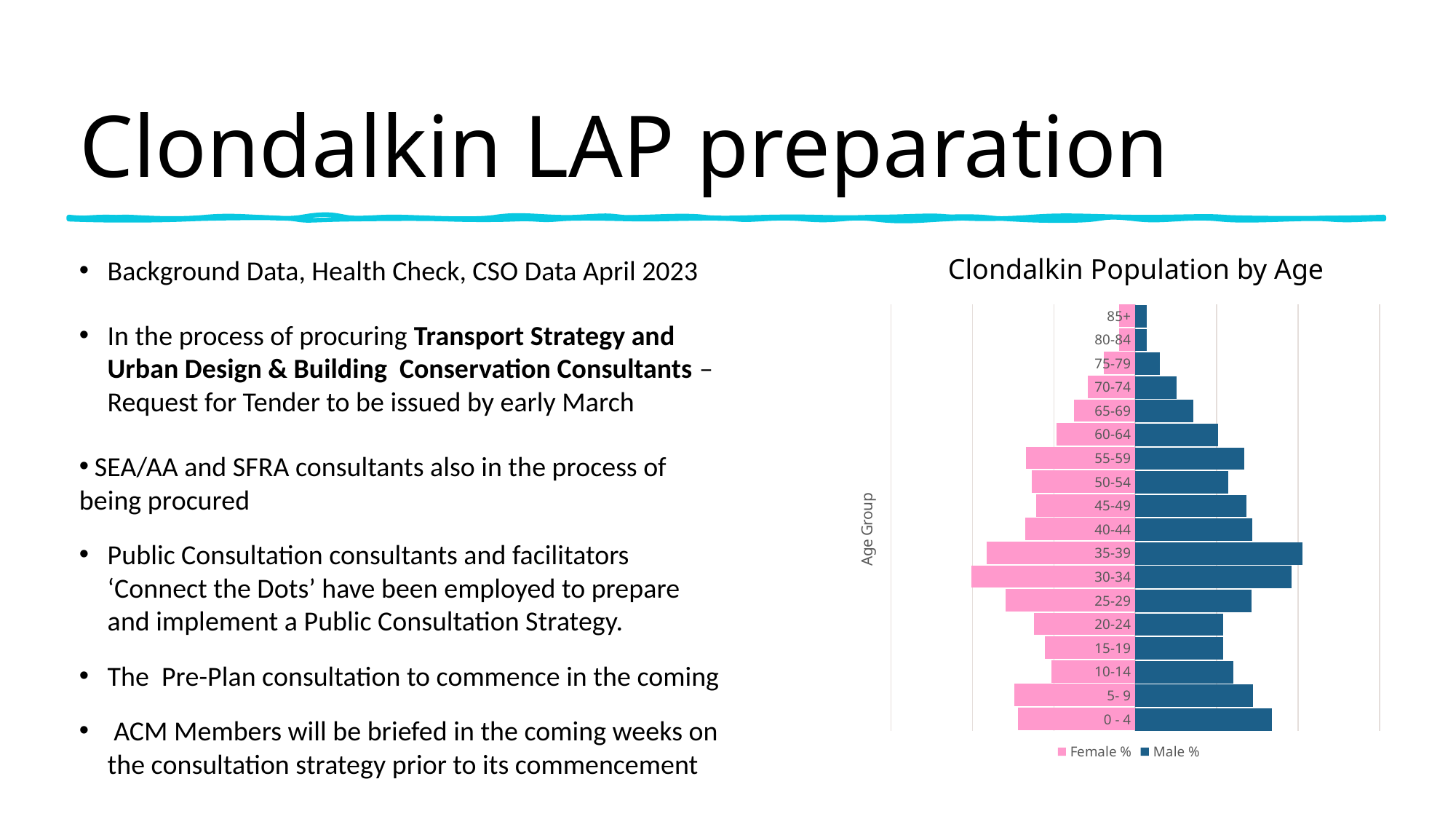
How many series does the chart's legend list? 2 What is the title of the chart on the slide? Clondalkin Population by Age Is the Female % bar longer for the 30-34 age group or the 60-64 age group? 30-34 Is the Male % bar longer for the 75-79 age group or the 55-59 age group? 55-59 What type of chart is shown on the slide? Bar chart How many age group categories are plotted in the chart? 18 Is the Male % bar longer for the 35-39 age group or the 0-4 age group? 35-39 Do the Male % bars generally get shorter or longer moving from the 35-39 age group up to the 85+ age group? Shorter What is the label on the vertical axis of the chart? Age Group What are the two series named in the chart's legend? Female % and Male % Which age group has the longest Female % bar? 30-34 Which age group has the longest Male % bar? 35-39